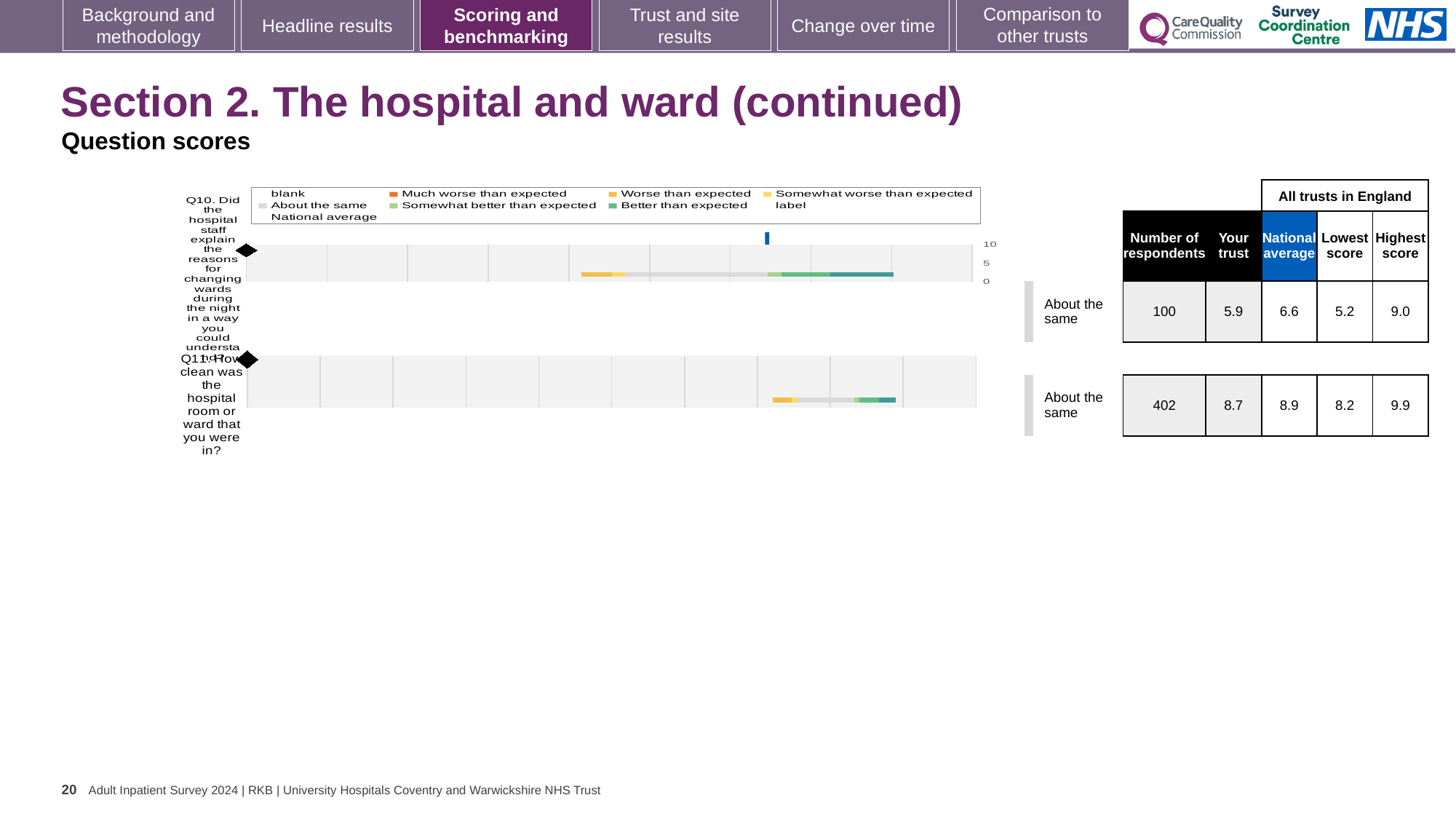
For Q10, which is larger: the trust's score or the national average? National average What is the national average score for Q10? 6.6 What benchmark category is shown for Q11? About the same What kind of chart is used to show the question scores on this slide? bar chart How many respondents answered Q11? 402 What is the highest score among all trusts in England for Q11? 9.9 Which question has the higher 'Your trust' score, Q10 or Q11? Q11 What is the difference between the national average and the trust's score for Q10? 0.7 What is the 'Your trust' score for Q11 (how clean was the hospital room or ward)? 8.7 How many questions are plotted in the question scores chart? 2 What is the 'Your trust' score for Q10 (explaining reasons for changing wards during the night)? 5.9 What is the maximum value shown on the score axis of the chart? 10